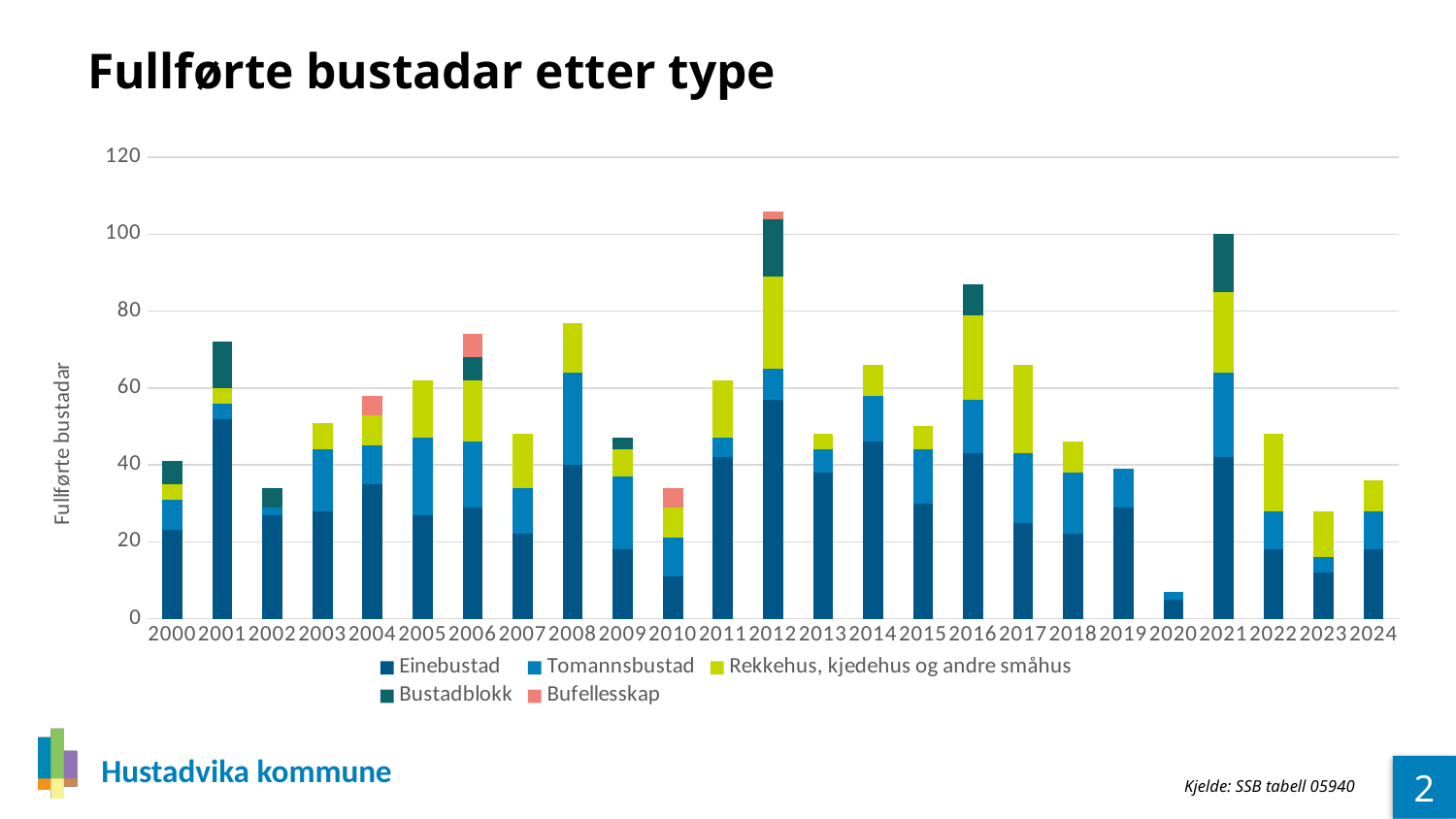
Is the total for 2001 greater or less than 60? greater Which year has the larger total, 2007 or 2008? 2008 What is the title of the chart? Fullførte bustadar etter type Which year has the lowest total of completed dwellings? 2020 Is the total for 2012 greater or less than 100? greater How many series does the legend list? 5 How many years are shown along the x axis? 25 Is the total for 2020 greater or less than 20? less Which year has the larger total, 2016 or 2017? 2016 Do the bar totals rise or fall from 2021 to 2023? fall What kind of chart is shown on the slide? Stacked bar chart